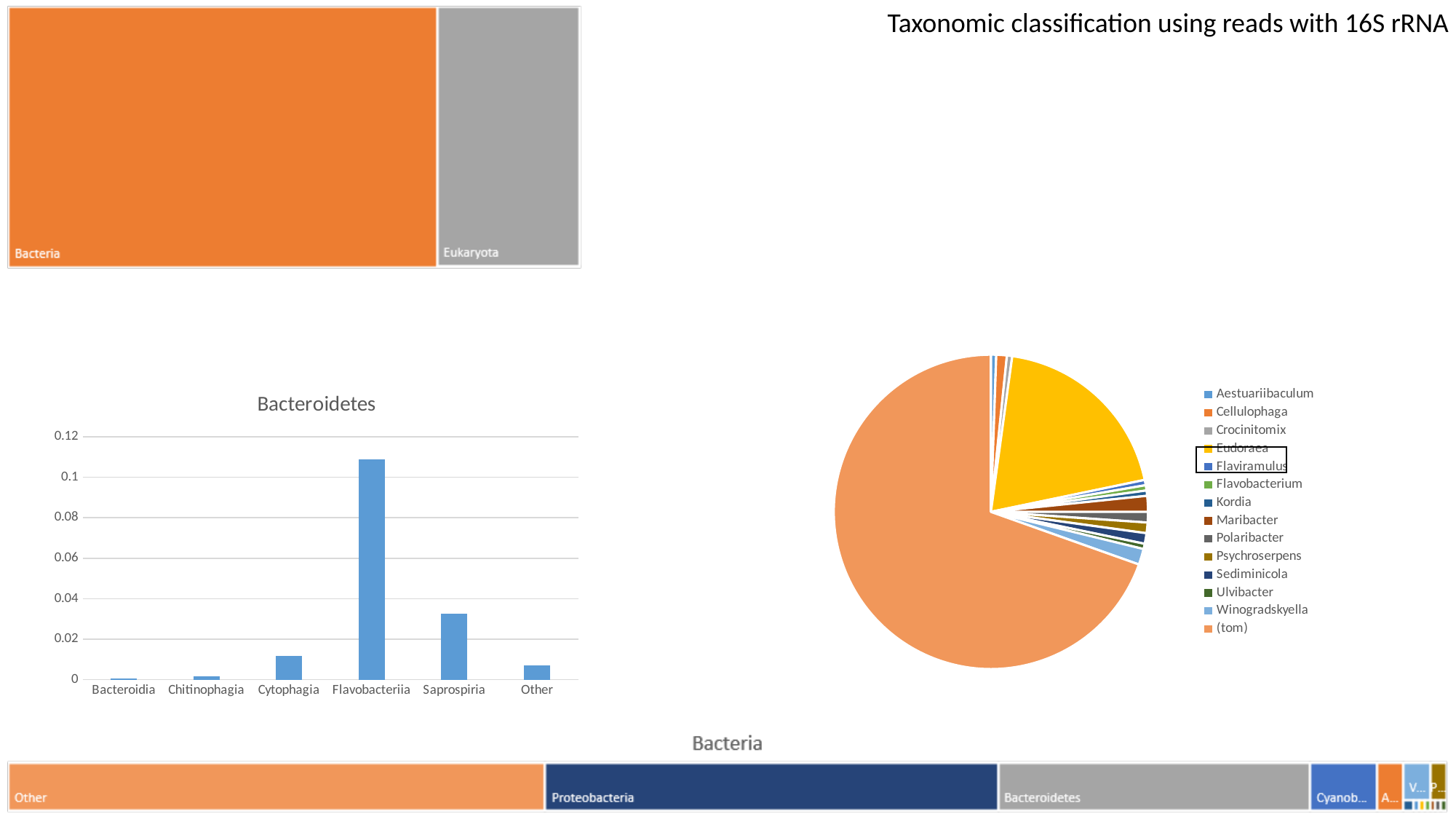
In the "Bacteroidetes" bar chart, which is larger, the value for Saprospiria or the value for Other? Saprospiria What kind of chart is the "Bacteroidetes" chart? bar chart In the "Bacteroidetes" bar chart, which category has the highest value? Flavobacteriia In the "Bacteroidetes" bar chart, is the value for Saprospiria greater or less than 0.04? less In the pie chart on the right, which legend entry is outlined with a box? Flaviramulus In the "Bacteroidetes" bar chart, which category has the lowest value? Bacteroidia How many categories are shown on the x axis of the "Bacteroidetes" bar chart? 6 In the pie chart on the right, which legend entry corresponds to the largest slice? (tom) How many entries does the legend of the pie chart on the right list? 14 In the "Bacteroidetes" bar chart, is the value for Flavobacteriia greater or less than 0.1? greater In the "Bacteroidetes" bar chart, is the value for Cytophagia greater or less than 0.02? less In the "Bacteroidetes" bar chart, which is larger, the value for Cytophagia or the value for Chitinophagia? Cytophagia